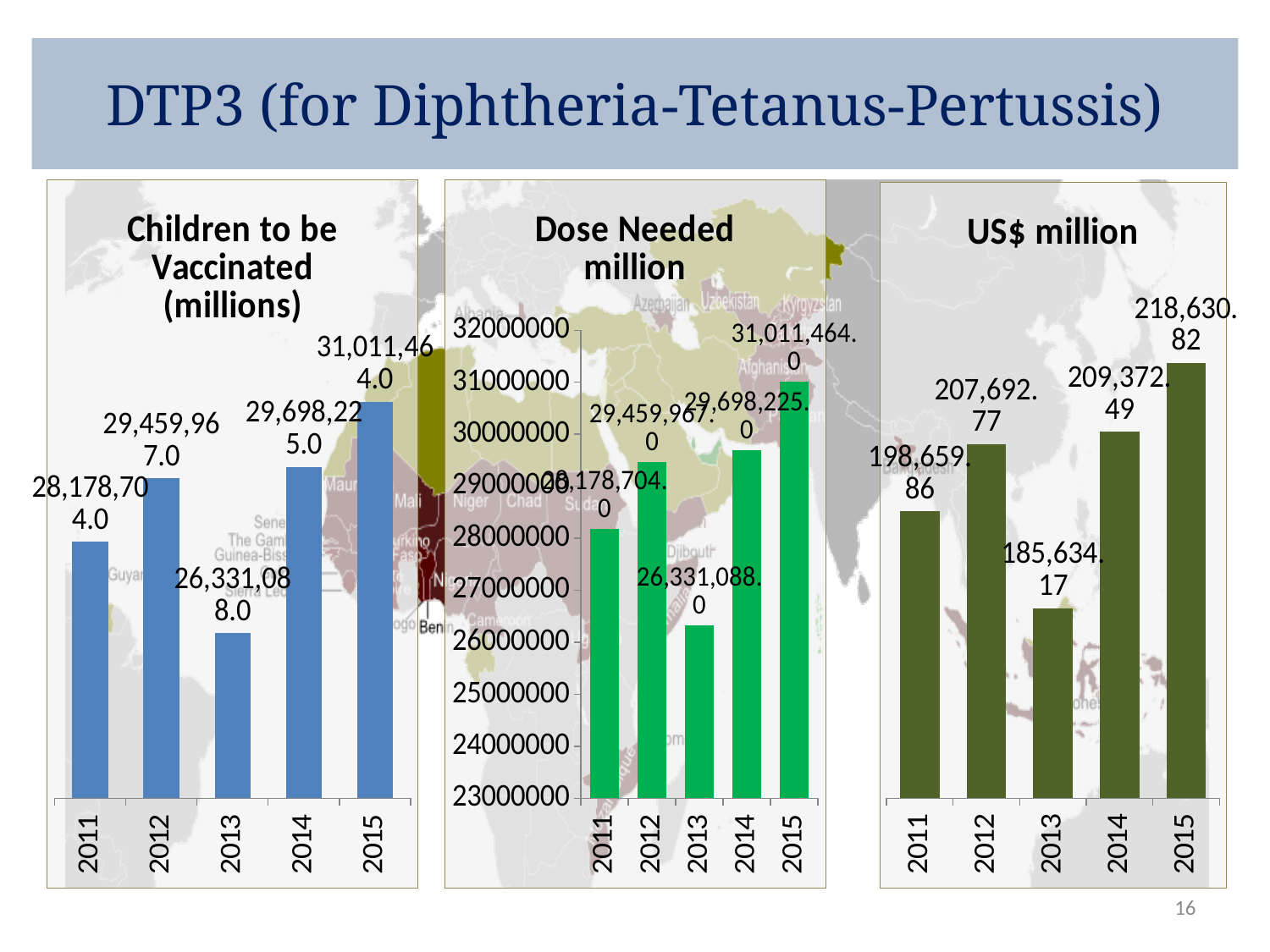
In the 'US$ million' chart, which year has the lowest value? 2013 In the 'Dose Needed million' chart, is the value for 2013 greater or less than 27000000? less In the 'Dose Needed million' chart, which year has the lowest value? 2013 In the 'US$ million' chart, what is the value for 2015? 218,630.82 In the 'Dose Needed million' chart, what is the value for 2014? 29,698,225.0 In the 'Children to be Vaccinated (millions)' chart, which is larger, the value for 2012 or the value for 2014? 2014 In the 'Children to be Vaccinated (millions)' chart, what is the value for 2011? 28,178,704.0 In the 'US$ million' chart, what is the value for 2013? 185,634.17 What kind of chart is the 'Dose Needed million' chart? bar chart In the 'US$ million' chart, what is the difference between the 2015 and 2011 values? 19,970.96 In the 'Children to be Vaccinated (millions)' chart, which year has the highest value? 2015 How many years are shown on the x axis of the 'US$ million' chart? 5